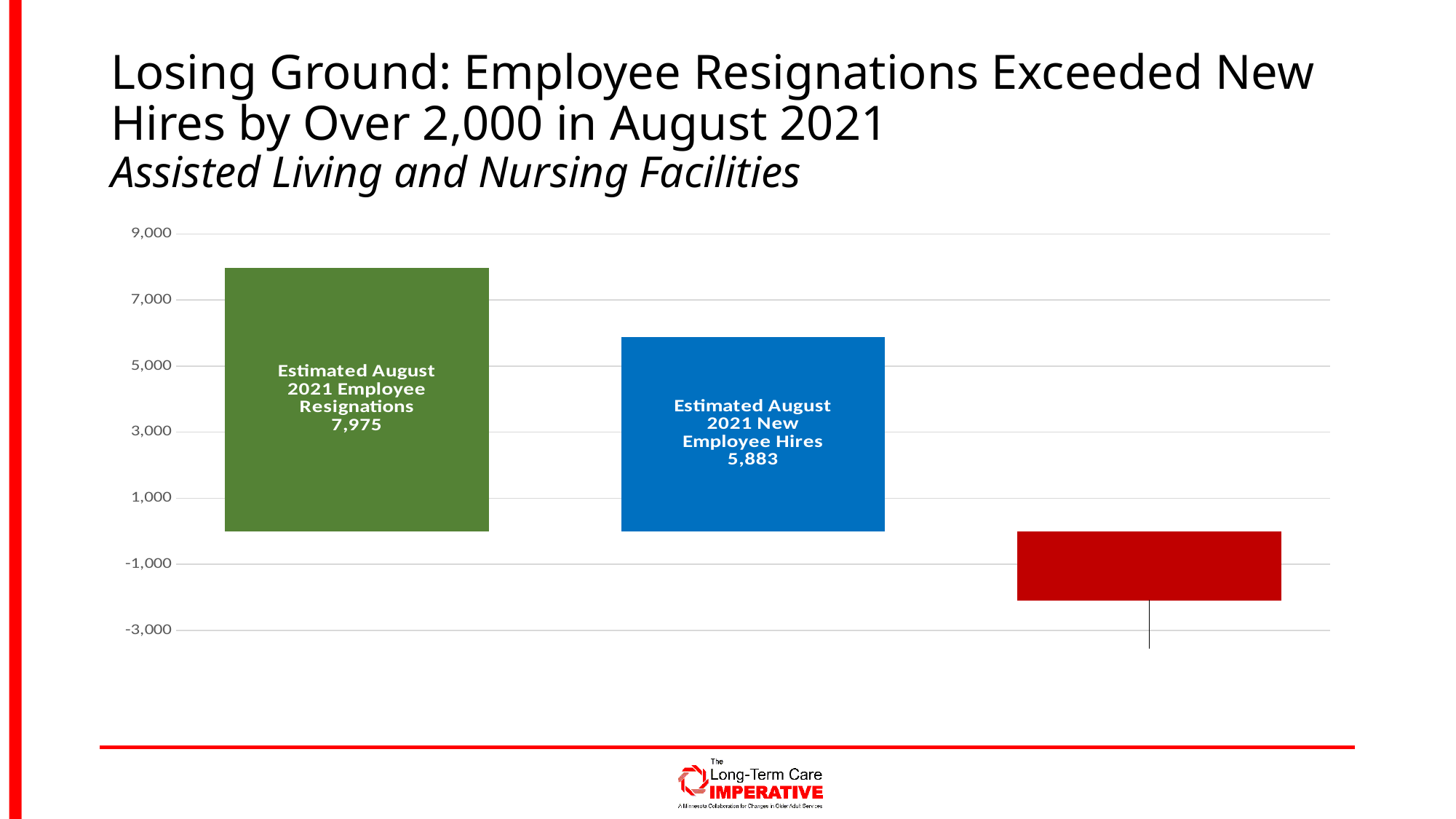
What is the italic subtitle below the slide title? Assisted Living and Nursing Facilities How many bars are plotted in the chart? 3 Is the value for Estimated August 2021 Employee Resignations greater or less than 7,000? greater Which of the labeled bars has the highest value? Estimated August 2021 Employee Resignations What is the difference between Estimated August 2021 Employee Resignations and Estimated August 2021 New Employee Hires? 2,092 Which is larger, Estimated August 2021 Employee Resignations or Estimated August 2021 New Employee Hires? Estimated August 2021 Employee Resignations What is the value shown for Estimated August 2021 Employee Resignations? 7,975 What kind of chart is shown on the slide? bar chart What colour is the bar for Estimated August 2021 New Employee Hires? blue Is the value of the red bar greater or less than -1,000? less Is the value for Estimated August 2021 New Employee Hires greater or less than 7,000? less What is the value shown for Estimated August 2021 New Employee Hires? 5,883